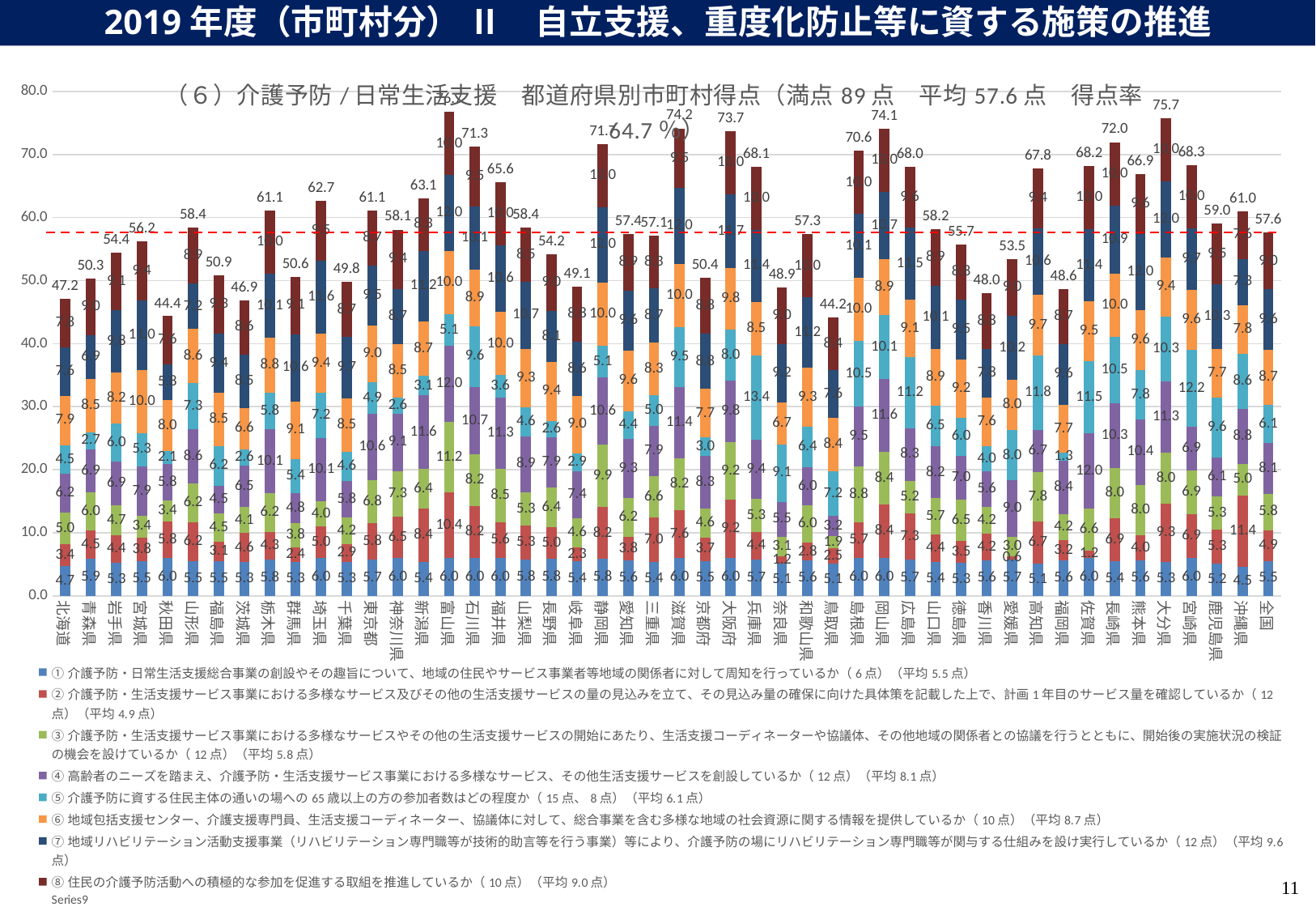
What is the total score shown for 沖縄県? 61.0 Is the total score for 滋賀県 greater or less than 70.0? greater What is the difference between the total score of 全国 (57.6) and 北海道 (47.2)? 10.4 What is the total score shown for 大分県? 75.7 What is the total score shown for 鳥取県? 44.2 Is the total score for 秋田県 greater or less than 50.0? less Which has a higher total score, 岡山県 or 広島県? 岡山県 Which has a higher total score, 埼玉県 or 千葉県? 埼玉県 What kind of chart is shown on the slide? Stacked bar chart What is the total score shown for 北海道? 47.2 What is the difference between the total scores of 大分県 (75.7) and 鳥取県 (44.2)? 31.5 What is the total score shown for 全国 (national) in the chart? 57.6